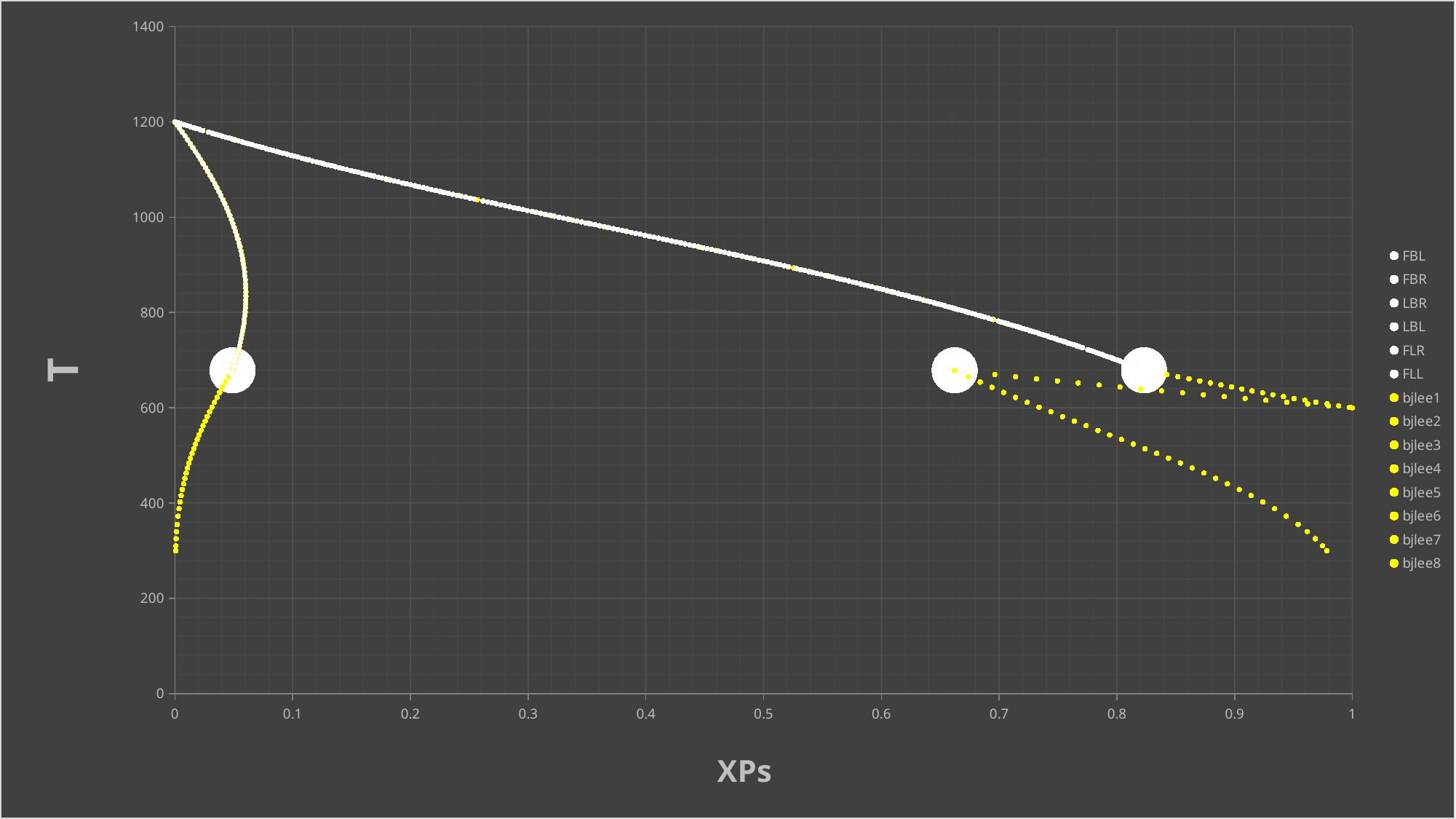
What is the label of the y axis? T What is the highest value shown on the T axis? 1400 What kind of chart is shown on the slide? scatter chart Is the T value of the lowest yellow point near XPs = 0.98 greater or less than 400? less Is the T value of the white line at XPs = 0.5 greater or less than 800? greater How many legend entries begin with "bjlee"? 8 How many series does the legend list? 14 What is the T value at which the white line starts at XPs = 0? 1200 How many large white circles are plotted on the chart? 3 Is the T value of the lowest yellow point at XPs = 0 greater or less than 400? less What is the label of the x axis? XPs Does the white line rise or fall as XPs increases from 0 to 0.8? fall